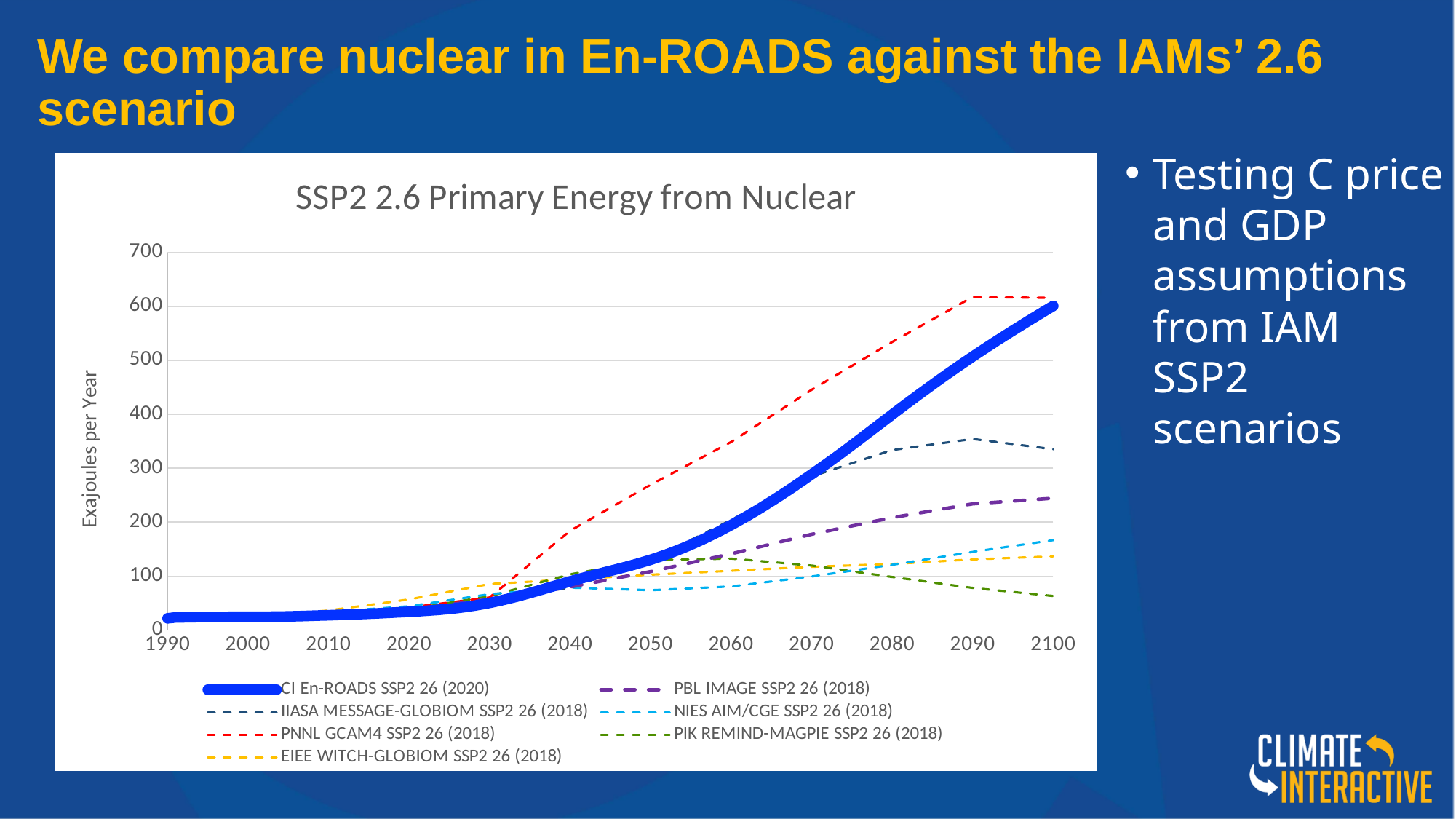
Which series has the lowest value in 2100? PIK REMIND-MAGPIE SSP2 26 (2018) Is the value for PIK REMIND-MAGPIE SSP2 26 (2018) in 2100 greater or less than 100? less In 2100, which is larger: IIASA MESSAGE-GLOBIOM SSP2 26 (2018) or PBL IMAGE SSP2 26 (2018)? IIASA MESSAGE-GLOBIOM SSP2 26 (2018) Is the value for PBL IMAGE SSP2 26 (2018) in 2100 greater or less than 300? less Is the value for NIES AIM/CGE SSP2 26 (2018) in 2100 greater or less than 100? greater What is the title of the chart? SSP2 2.6 Primary Energy from Nuclear What is the label on the y axis? Exajoules per Year What kind of chart is shown on the slide? line chart Does the PIK REMIND-MAGPIE SSP2 26 (2018) series rise or fall from 2060 to 2100? fall How many series does the legend list? 7 Does the CI En-ROADS SSP2 26 (2020) series rise or fall from 1990 to 2100? rise